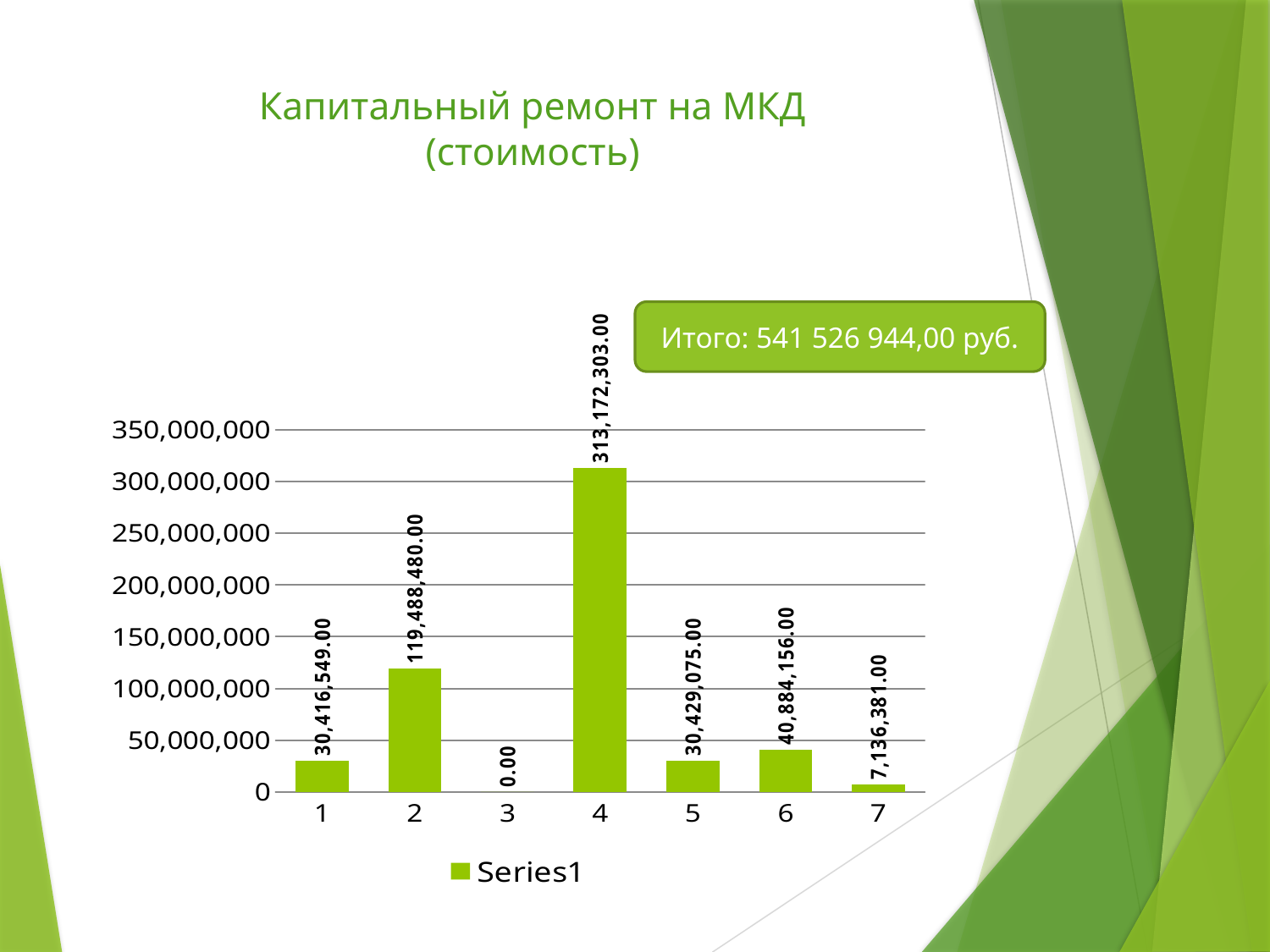
Which is larger, the value for category 2 or the value for category 6? category 2 What is the value for category 7? 7,136,381.00 What type of chart is shown on the slide? bar chart What is the value for category 4? 313,172,303.00 What is the value for category 3? 0.00 Which category has the lowest value? 3 What is the difference between the values for category 4 and category 2? 193,683,823.00 How many categories are shown on the x axis? 7 What is the difference between the values for category 6 and category 5? 10,455,081.00 Which category has the highest value? 4 Is the value for category 2 greater or less than 100,000,000? greater What is the value for category 2? 119,488,480.00